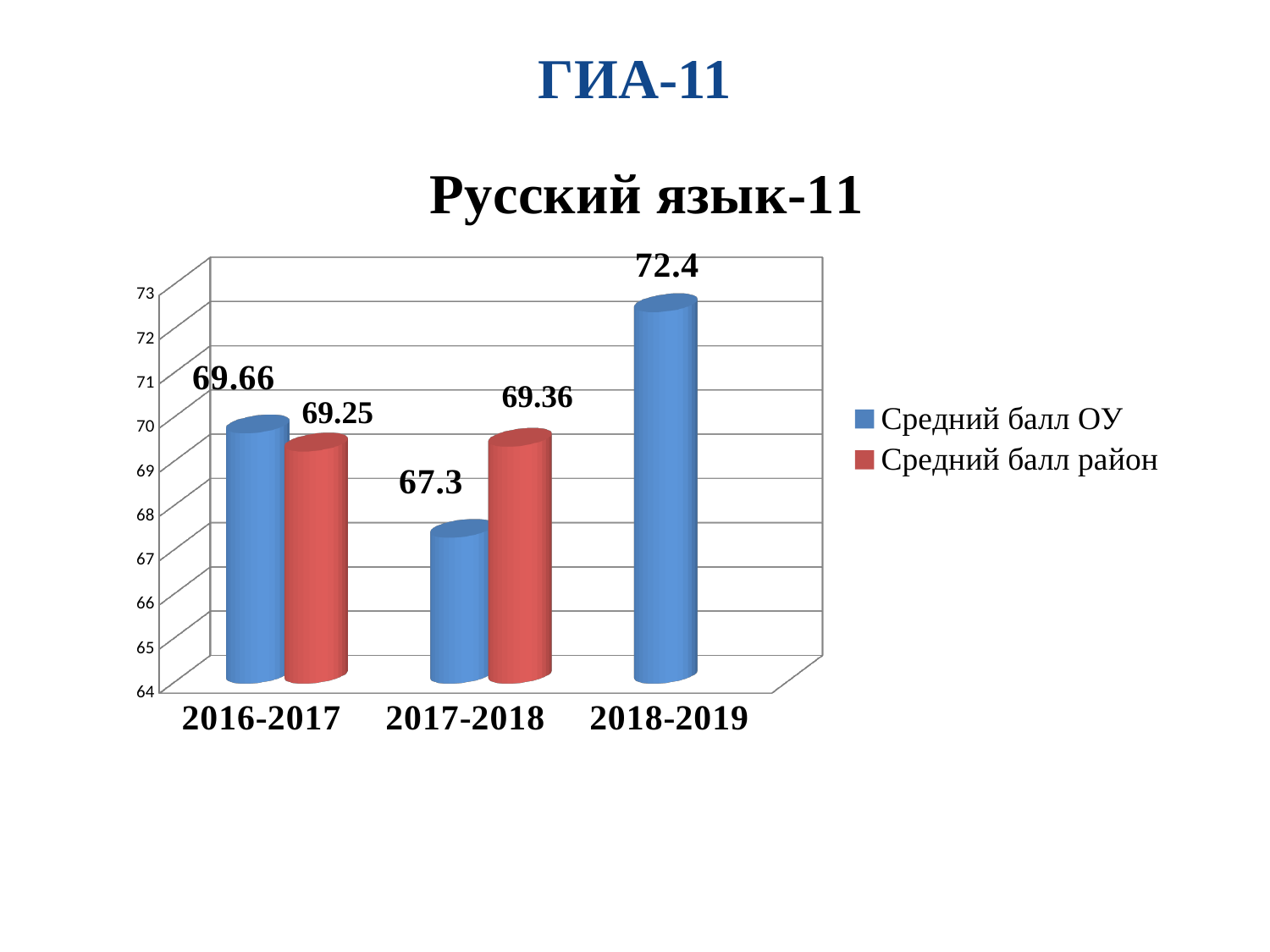
How many year categories are shown on the x axis? 3 What is the title of the chart? Русский язык-11 Which is larger in 2016-2017: Средний балл ОУ or Средний балл район? Средний балл ОУ How many series does the legend list? 2 What is the value of Средний балл ОУ for 2016-2017? 69.66 In which year is Средний балл ОУ the lowest? 2017-2018 What is the value of Средний балл район for 2016-2017? 69.25 What is the value of Средний балл район for 2017-2018? 69.36 What kind of chart is shown? Bar chart What is the difference between Средний балл район and Средний балл ОУ in 2017-2018? 2.06 In which year is Средний балл ОУ the highest? 2018-2019 What is the value of Средний балл ОУ for 2018-2019? 72.4